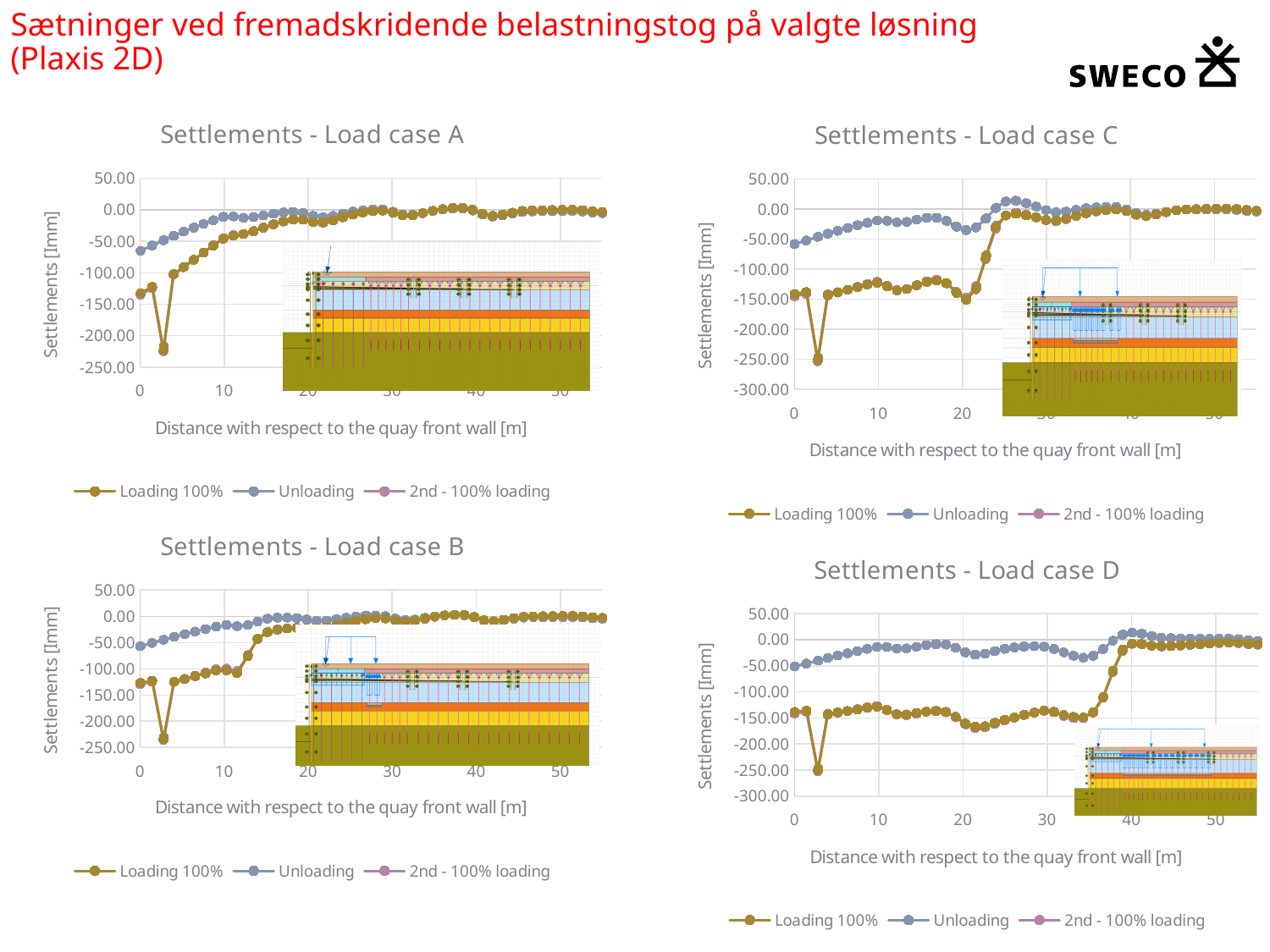
What kind of chart is 'Settlements - Load case A'? line chart What are the three series named in the legend of 'Settlements - Load case B'? Loading 100%, Unloading, 2nd - 100% loading In 'Settlements - Load case A', which series has the lower value at distance 0, Loading 100% or Unloading? Loading 100% In 'Settlements - Load case B', is the Unloading value at distance 0 greater or less than -100? greater What is the x-axis label of 'Settlements - Load case D'? Distance with respect to the quay front wall [m] How many series does the legend of 'Settlements - Load case C' list? 3 In 'Settlements - Load case A', is the Unloading value at distance 0 greater or less than -100? greater In 'Settlements - Load case D', is the Loading 100% value at distance 10 greater or less than -150? greater In 'Settlements - Load case D', does the Loading 100% series rise or fall between distance 30 and distance 40? rise